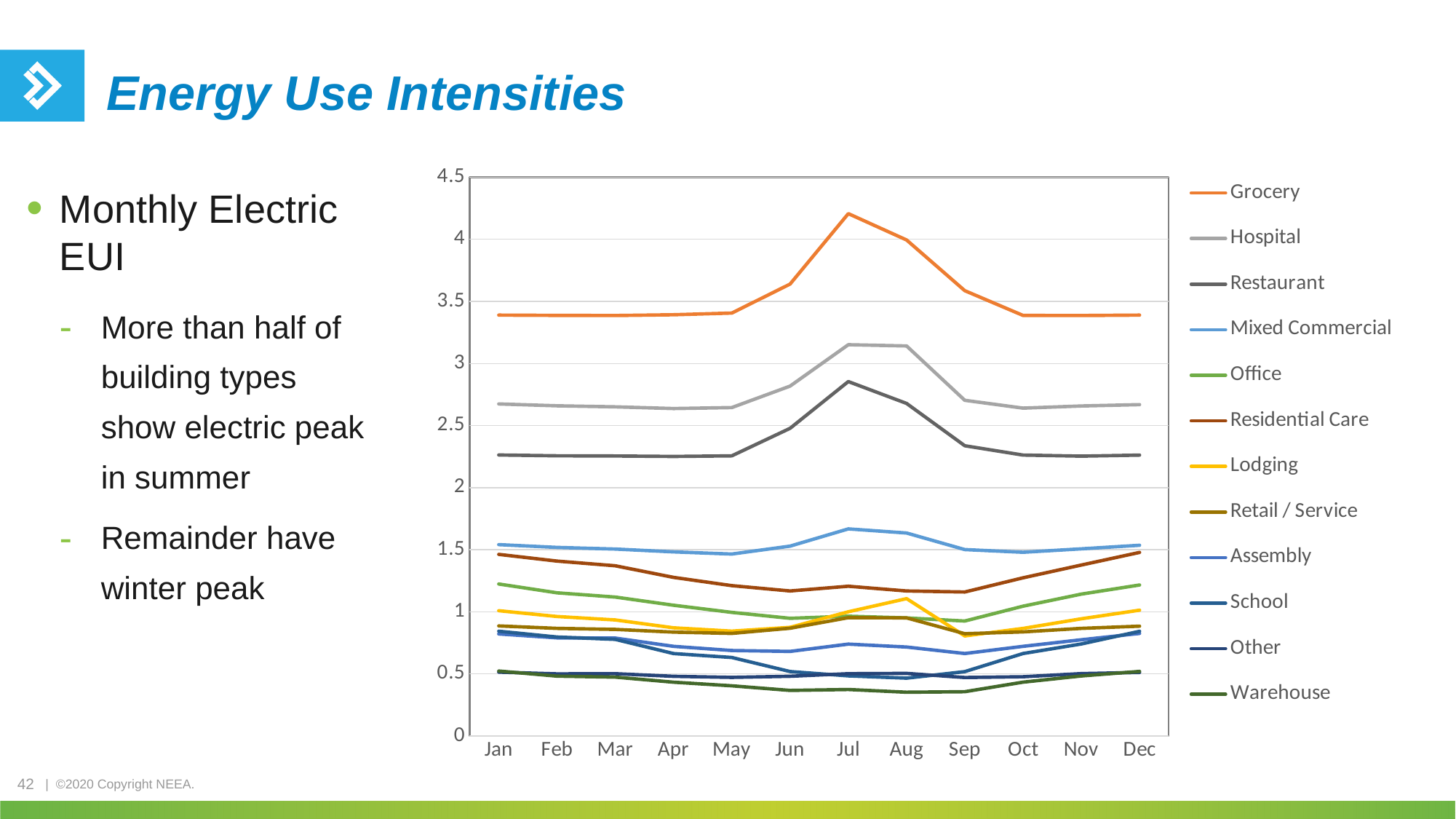
Which building type has the highest value in Jul? Grocery How many months are shown along the x axis? 12 How many series does the legend list? 12 What colour is the Grocery line in the legend? orange Is the value for Hospital in Jan greater or less than 2.5? greater Is the value for Mixed Commercial in Jul greater or less than 1.5? greater Which is larger in Jan, Hospital or Restaurant? Hospital Does the Grocery line rise or fall from Jan to Jul? rise Which building type has the lowest value in Jun? Warehouse Is the value for Restaurant in Jul greater or less than 3? less What kind of chart is shown on the slide? line chart